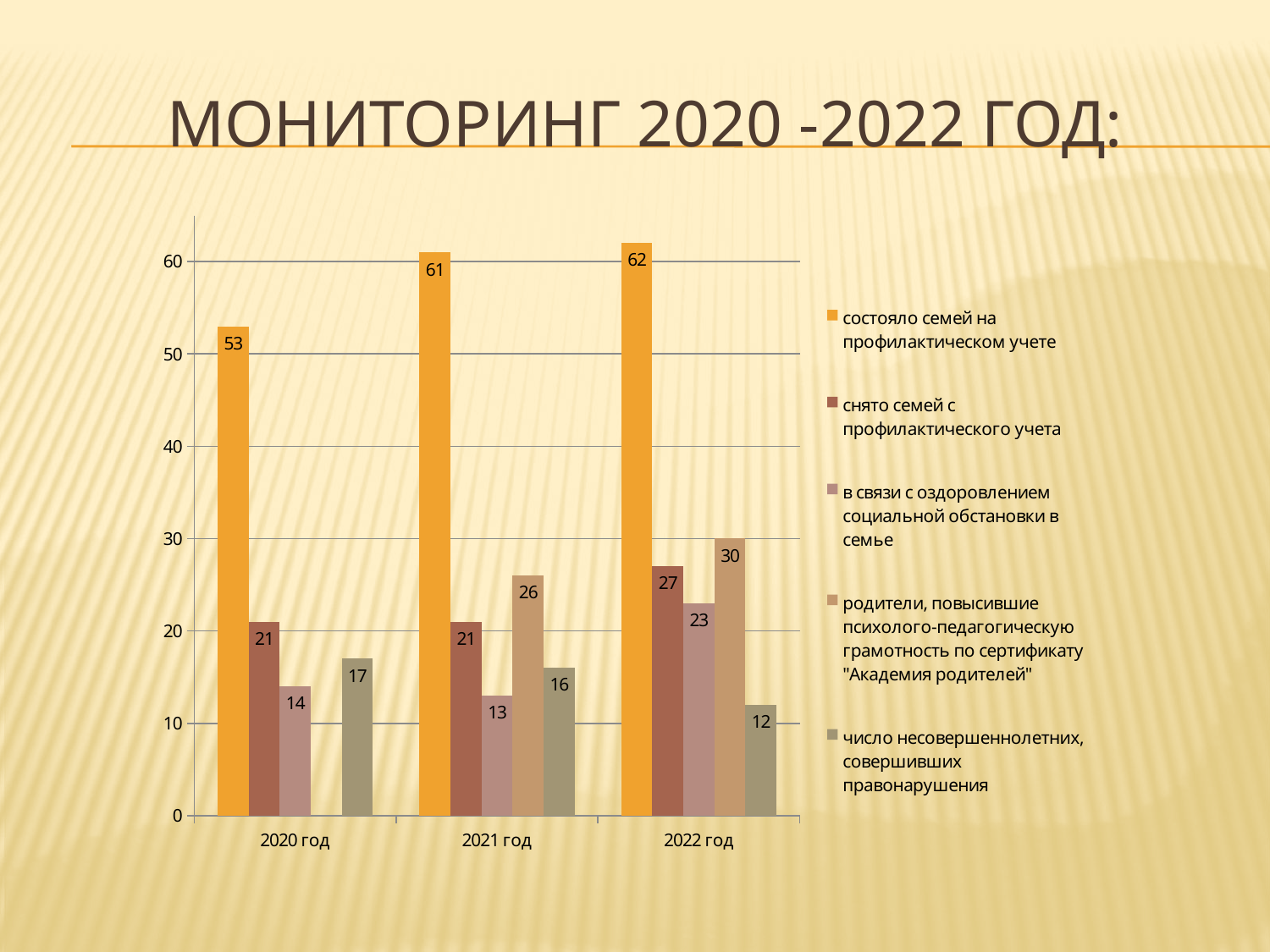
What kind of chart is shown on the slide? Bar chart Which is larger: "в связи с оздоровлением социальной обстановки в семье" in 2022 год or in 2021 год? 2022 год In which year is the value for "число несовершеннолетних, совершивших правонарушения" the lowest? 2022 год How many year categories are shown on the x axis? 3 How many series does the legend list? 5 What is the value for "снято семей с профилактического учета" in 2022 год? 27 What is the value for "родители, повысившие психолого-педагогическую грамотность по сертификату "Академия родителей"" in 2021 год? 26 What is the value for "состояло семей на профилактическом учете" in 2020 год? 53 In which year is the value for "состояло семей на профилактическом учете" the highest? 2022 год Does the value for "число несовершеннолетних, совершивших правонарушения" rise or fall from 2020 год to 2022 год? Fall What is the value for "число несовершеннолетних, совершивших правонарушения" in 2020 год? 17 What is the difference between the values for "состояло семей на профилактическом учете" in 2022 год and 2020 год? 9